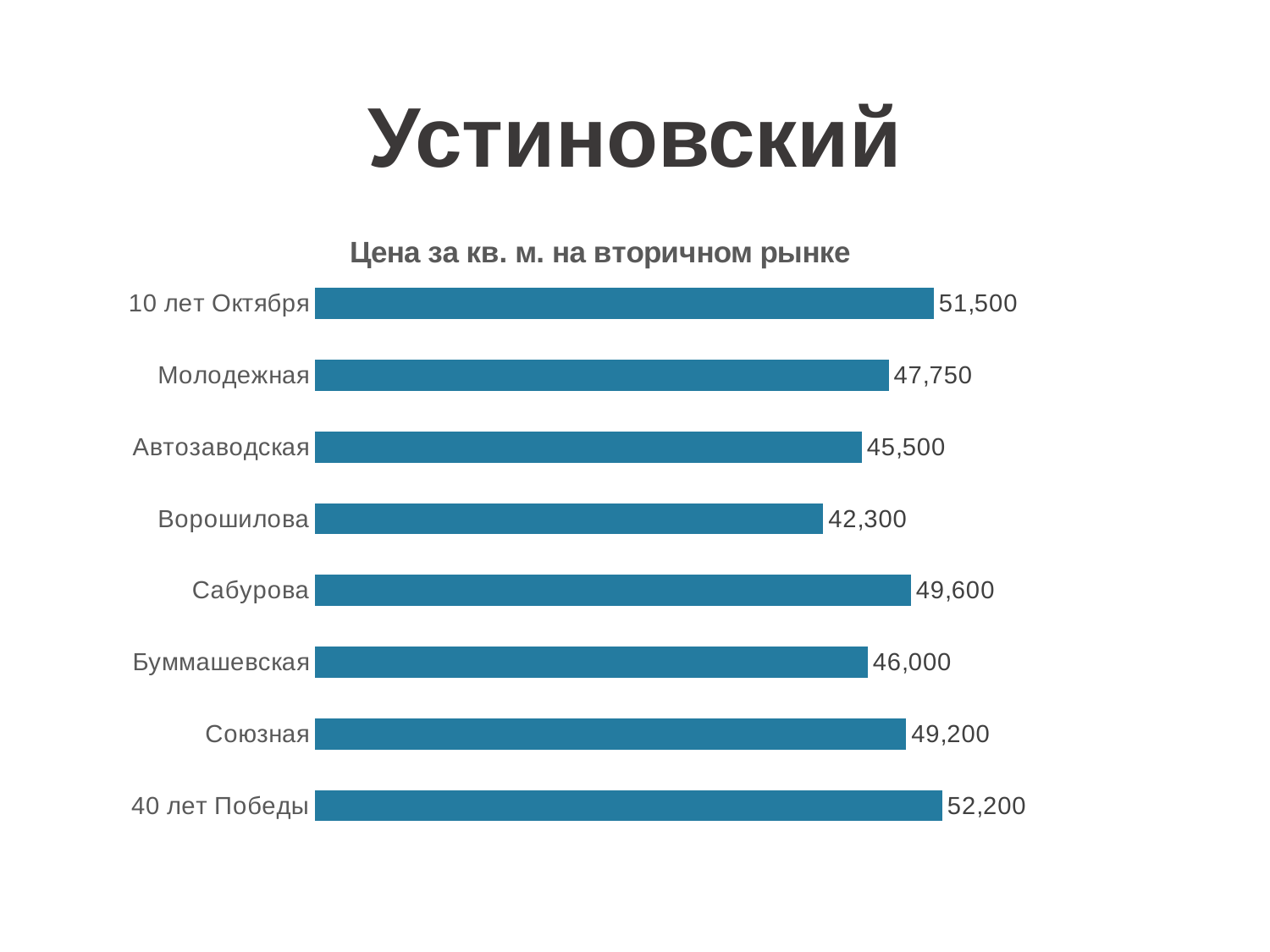
What is the value shown for Ворошилова? 42,300 What is the price per sq. m. for Молодежная? 47,750 What is the difference between the values for Буммашевская and Автозаводская? 500 Which is larger, the value for Молодежная or the value for Буммашевская? Молодежная Which street has the highest price per sq. m.? 40 лет Победы How many streets are shown in the chart? 8 Which street has the lowest price per sq. m.? Ворошилова Which is larger, the value for Сабурова or the value for Союзная? Сабурова What is the difference between the values for 40 лет Победы and 10 лет Октября? 700 What kind of chart is shown on the slide? Bar chart What is the value shown for Сабурова? 49,600 What is the title of the chart? Цена за кв. м. на вторичном рынке